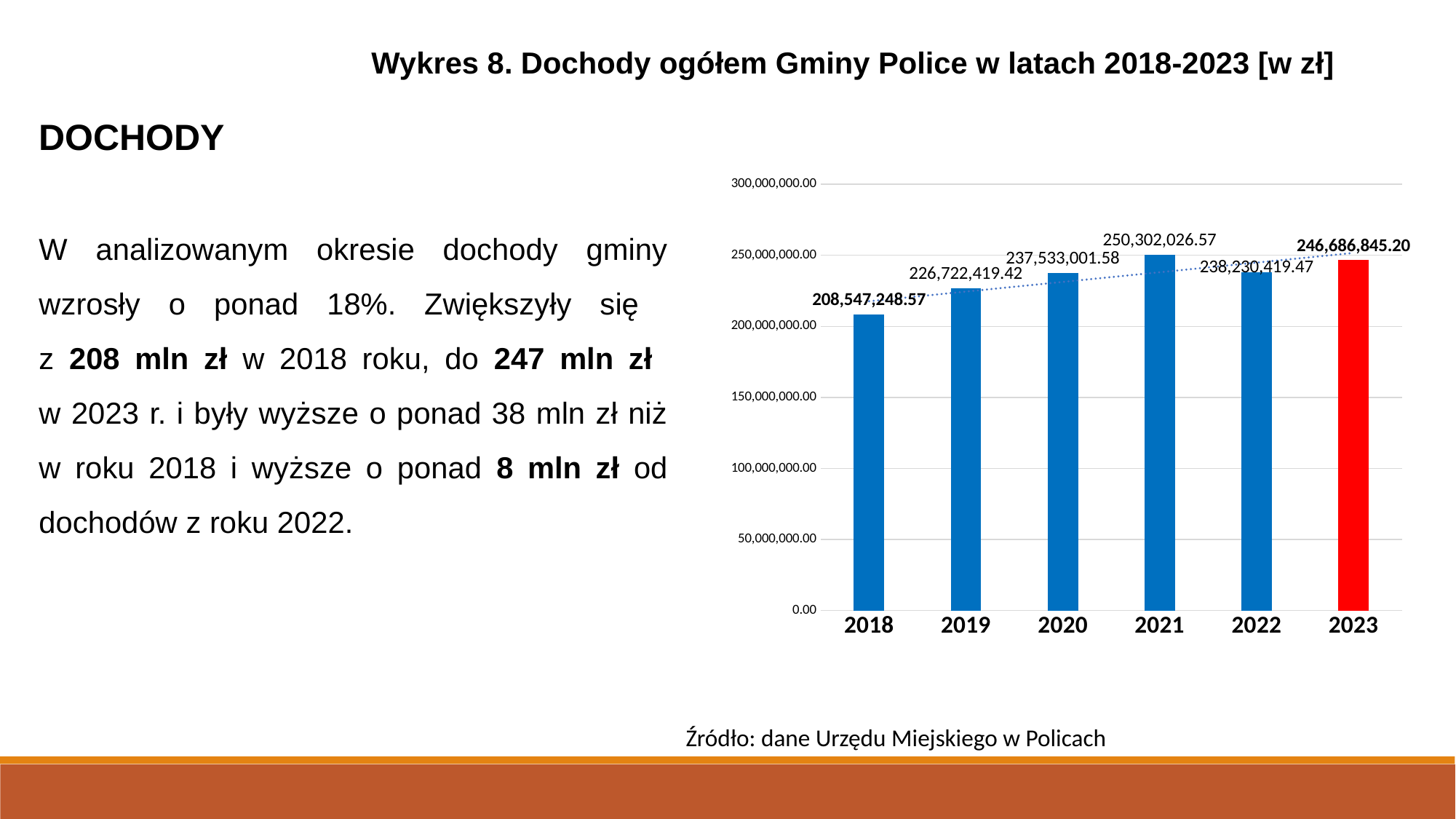
What is the value for 2023? 246,686,845.20 What type of chart is shown on the slide? bar chart Which is larger, the value for 2019 or the value for 2022? 2022 What is the difference between the values for 2023 and 2022? 8,456,425.73 Which year has the lowest value? 2018 What is the value for 2021? 250,302,026.57 What is the value for 2018? 208,547,248.57 What is the title of the chart? Wykres 8. Dochody ogółem Gminy Police w latach 2018-2023 [w zł] How many years are plotted on the chart? 6 Which year has the highest value? 2021 What is the difference between the values for 2023 and 2018? 38,139,596.63 Which bar is coloured red rather than blue? 2023